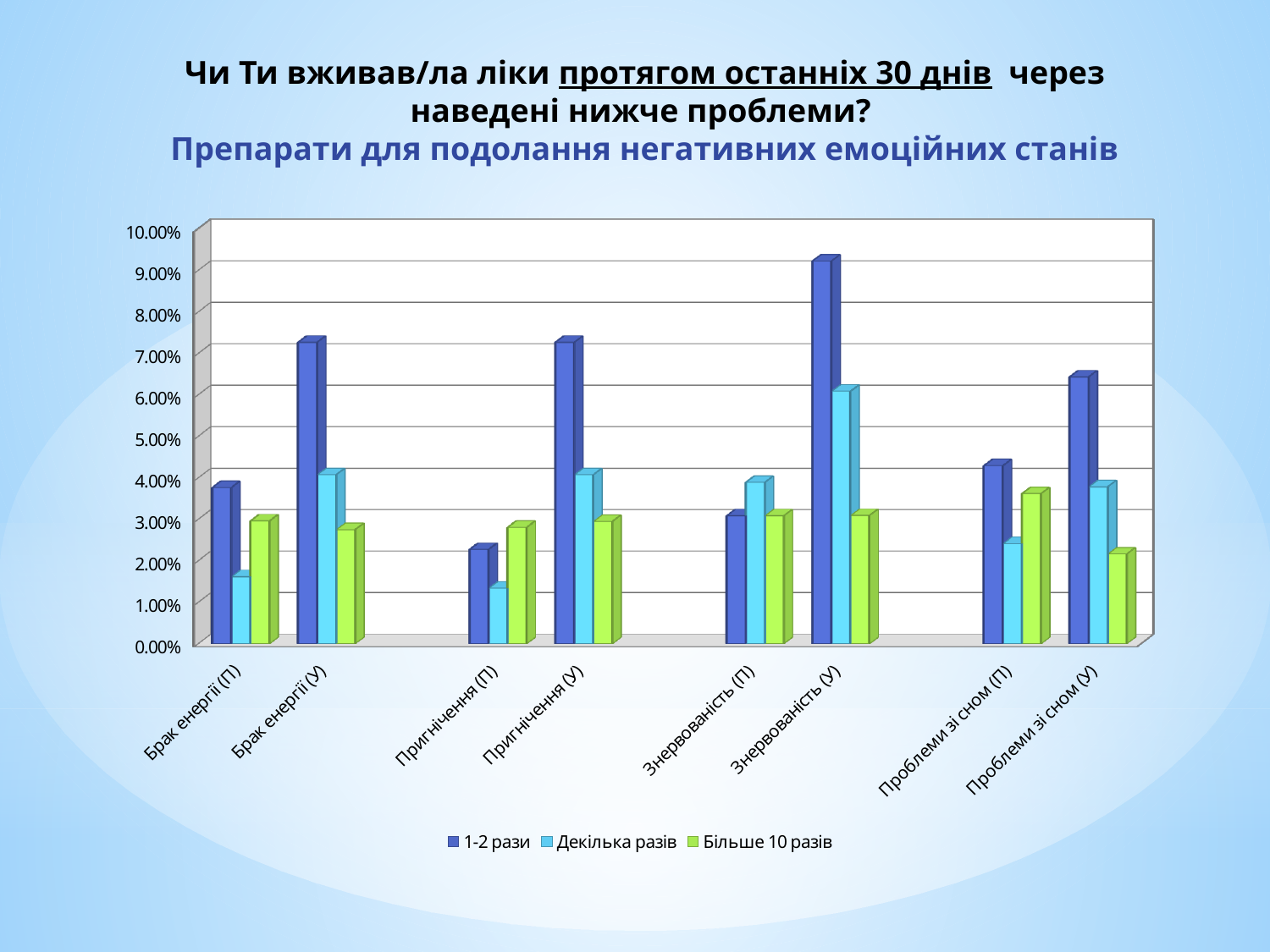
Which category has the highest value for the series "1-2 рази"? Знервованість (У) Is the value for "1-2 рази" in the category "Пригнічення (П)" greater or less than 3.00%? less Is the value for "1-2 рази" in the category "Знервованість (У)" greater or less than 8.00%? greater How many categories are shown along the x axis of the chart? 8 How many series does the chart's legend list? 3 Which category has the highest value for the series "Декілька разів"? Знервованість (У) In the category "Проблеми зі сном (П)", which series has the larger value: "1-2 рази" or "Декілька разів"? 1-2 рази Which category has the lowest value for the series "1-2 рази"? Пригнічення (П) Is the value for "Декілька разів" in the category "Знервованість (У)" greater or less than 5.00%? greater What are the three series listed in the chart's legend? 1-2 рази, Декілька разів, Більше 10 разів What kind of chart is shown on the slide? bar chart For the series "1-2 рази", which category has the larger value: "Брак енергії (У)" or "Проблеми зі сном (У)"? Брак енергії (У)